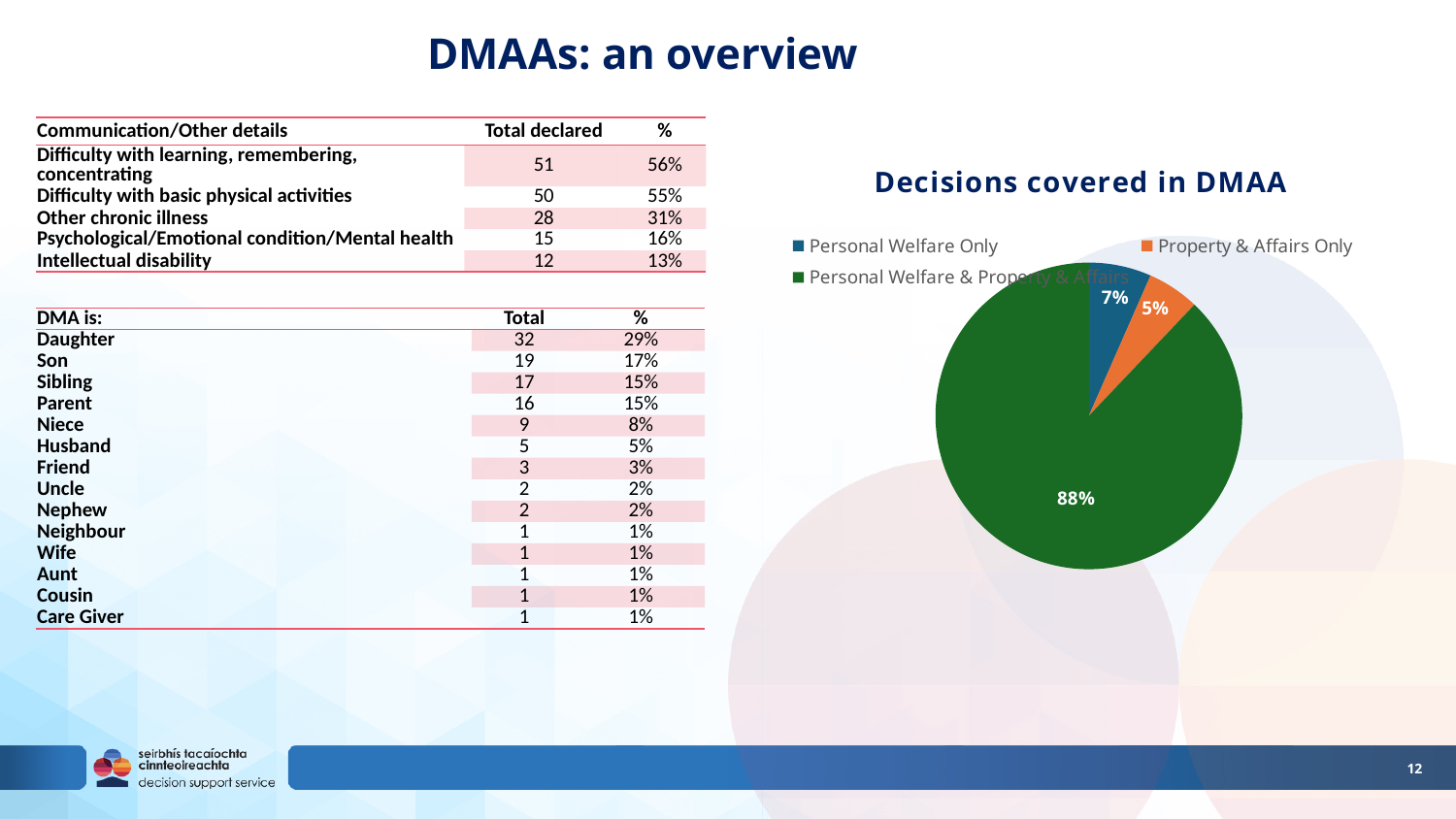
What share of the pie is Personal Welfare & Property & Affairs? 88% What colour is the Property & Affairs Only slice? orange Which is larger: the Personal Welfare Only slice or the Property & Affairs Only slice? Personal Welfare Only Which category has the smallest slice of the pie? Property & Affairs Only What share of the pie is Property & Affairs Only? 5% What kind of chart is shown on the slide? pie chart How many slices does the pie chart have? 3 What is the title of the pie chart? Decisions covered in DMAA How many entries does the pie chart legend list? 3 Which category has the largest slice of the pie? Personal Welfare & Property & Affairs What is the difference between the Personal Welfare Only share and the Property & Affairs Only share? 2% What share of the pie is Personal Welfare Only? 7%